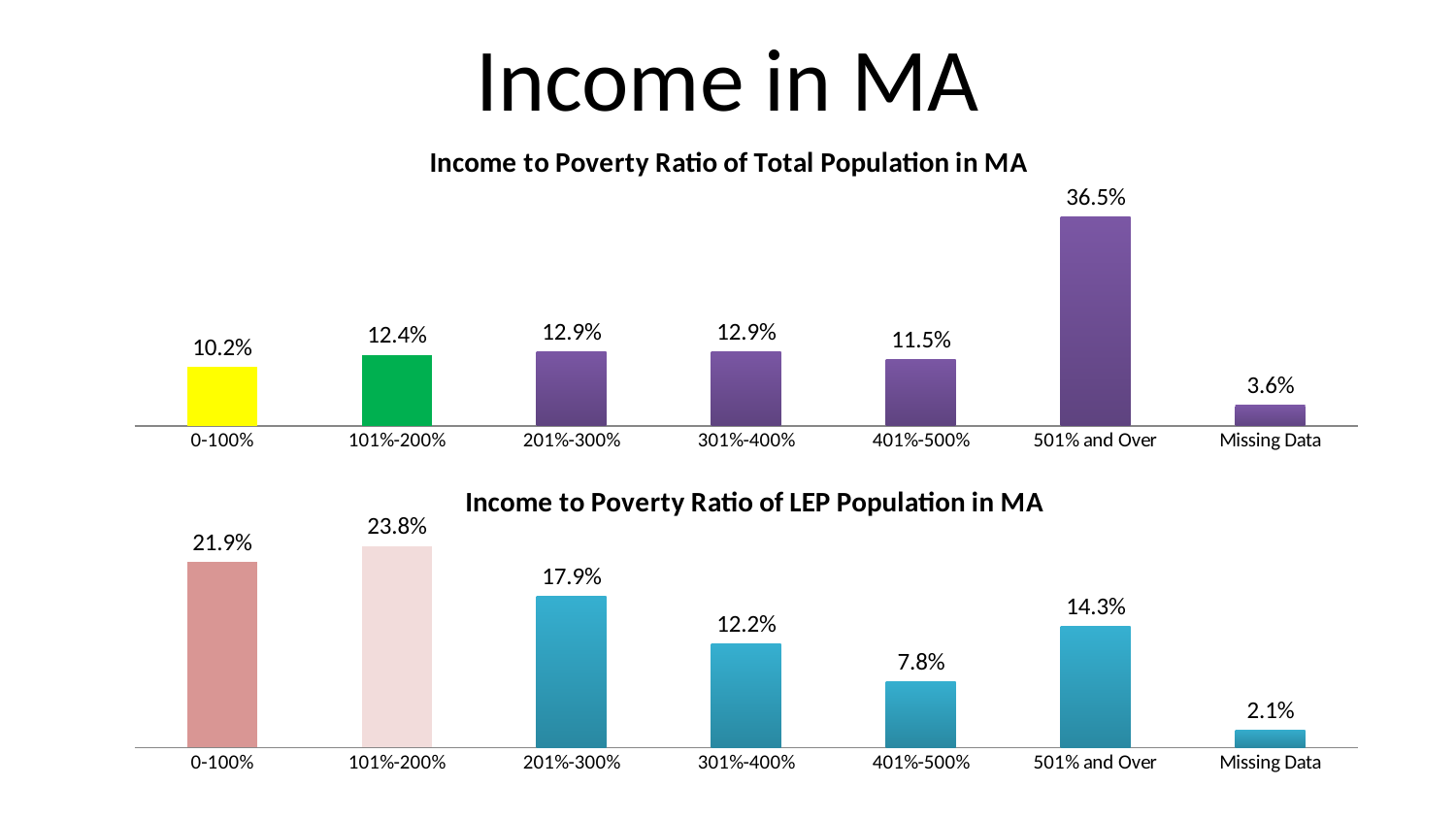
How many categories are shown in the 'Income to Poverty Ratio of LEP Population in MA' chart? 7 In the 'Income to Poverty Ratio of Total Population in MA' chart, which category has the lowest value? Missing Data In the 'Income to Poverty Ratio of Total Population in MA' chart, what is the difference between the values for 501% and Over and 401%-500%? 25.0% In the 'Income to Poverty Ratio of LEP Population in MA' chart, what is the difference between the values for 101%-200% and 0-100%? 1.9% What is the title of the bottom chart on the slide? Income to Poverty Ratio of LEP Population in MA In the 'Income to Poverty Ratio of Total Population in MA' chart, what is the value for 501% and Over? 36.5% In the 'Income to Poverty Ratio of LEP Population in MA' chart, which category has the highest value? 101%-200% Which is larger: the value for 0-100% in the Total Population chart or the value for 0-100% in the LEP Population chart? LEP Population chart What type of chart is the 'Income to Poverty Ratio of Total Population in MA' chart? Bar chart In the 'Income to Poverty Ratio of Total Population in MA' chart, which category has the highest value? 501% and Over In the 'Income to Poverty Ratio of LEP Population in MA' chart, what is the value for 0-100%? 21.9% In the 'Income to Poverty Ratio of LEP Population in MA' chart, what is the value for 401%-500%? 7.8%